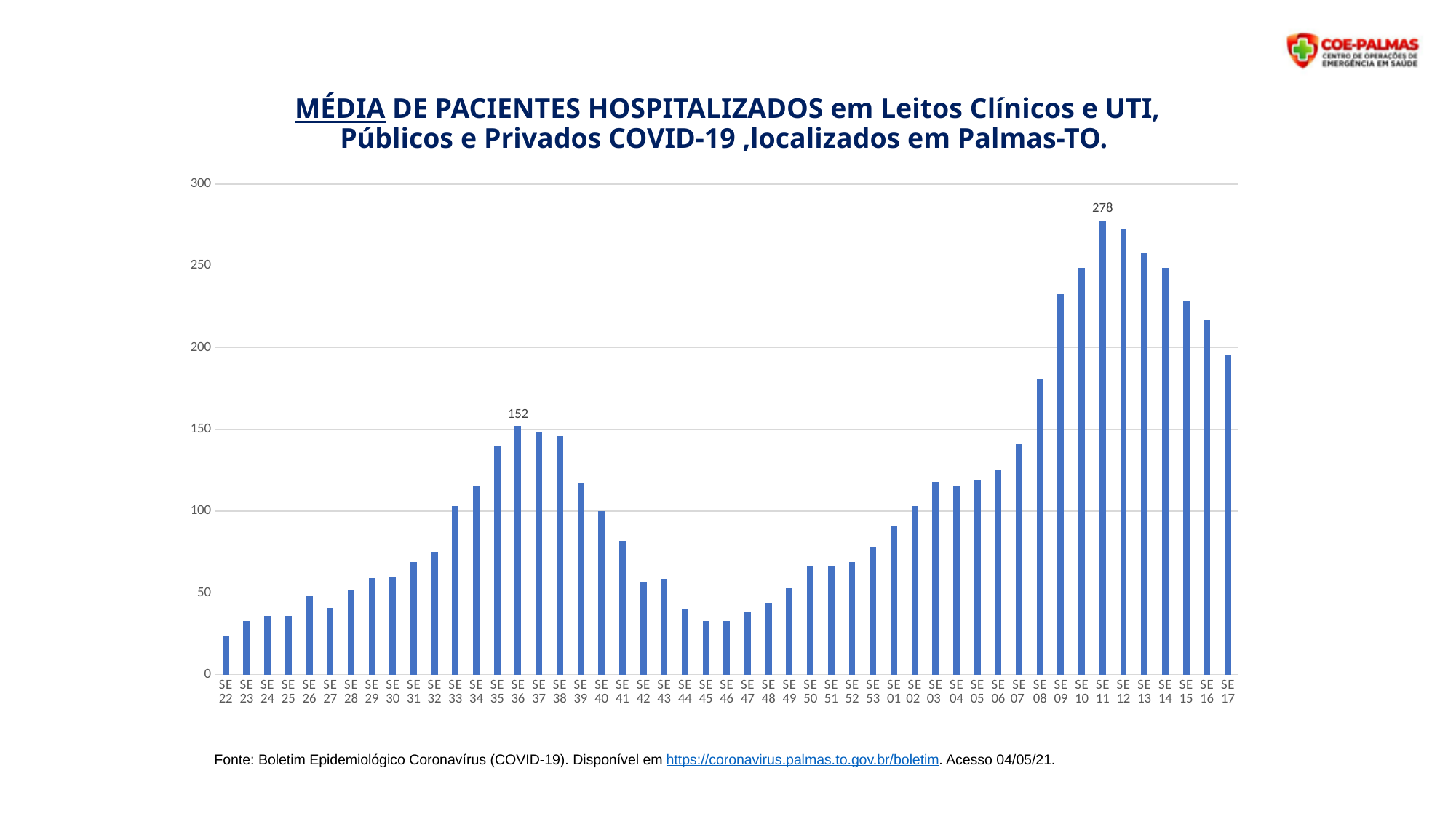
What type of chart is shown on the slide? bar chart What is the difference between the values for SE 11 and SE 36? 126 How many weeks (bars) are plotted on the chart? 49 Is the value for SE 41 greater or less than 100? less What is the value for SE 36? 152 Is the value for SE 09 greater or less than 200? greater Which week has the lowest value? SE 22 Which is larger, the value for SE 36 or the value for SE 11? SE 11 What is the value for SE 11? 278 Do the values rise or fall from SE 11 to SE 17? fall Is the value for SE 17 greater or less than 200? less Which week has the highest value? SE 11